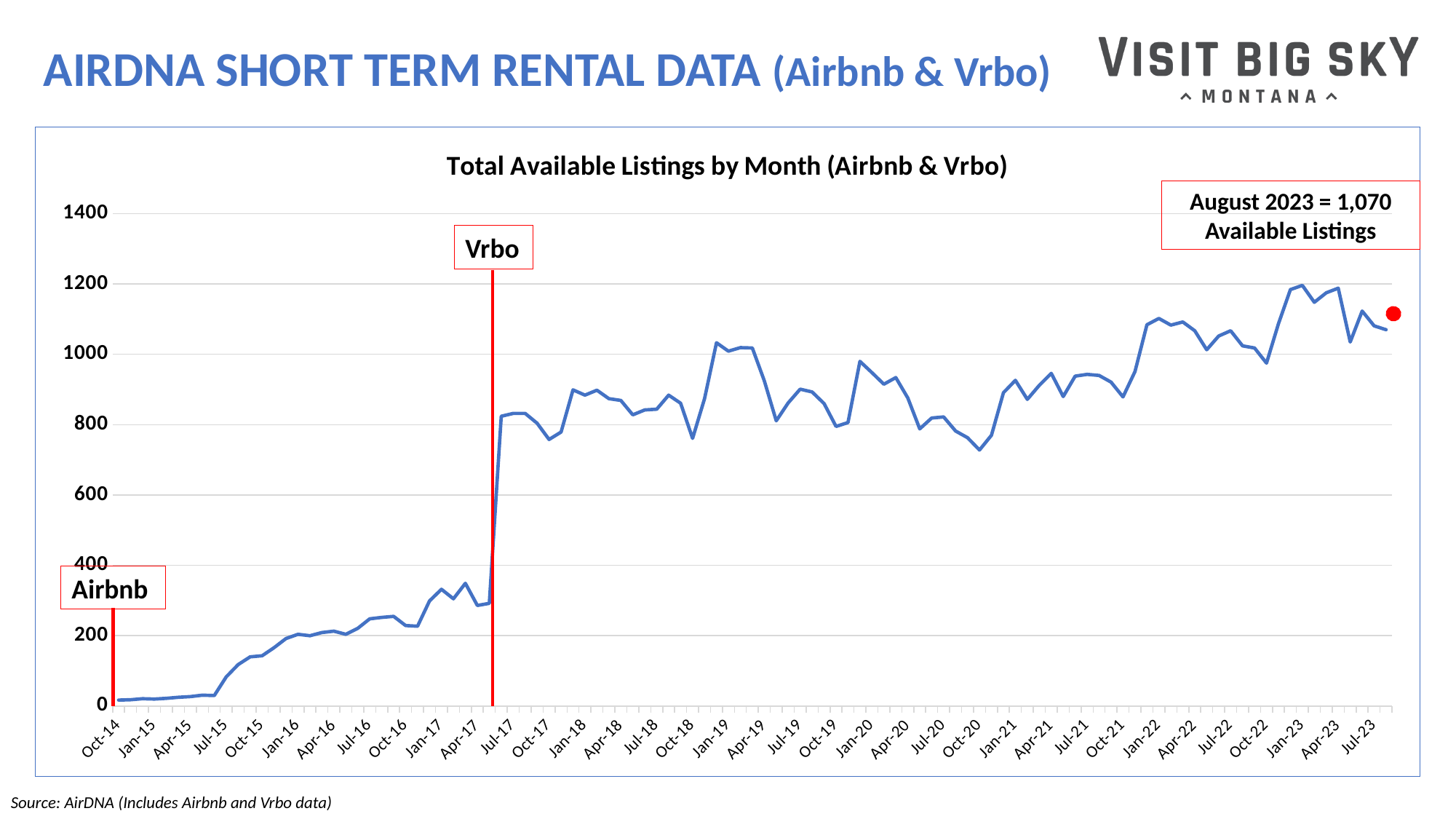
Overall, do the values rise or fall from Oct-14 to Jul-23? rise What is the title of the chart? Total Available Listings by Month (Airbnb & Vrbo) Which is larger, the value for Jan-16 or the value for Jan-18? Jan-18 Is the value for Jul-17 greater or less than 600? greater What kind of chart is shown on the slide? line chart What label is on the first red vertical line near the start of the chart? Airbnb Is the value for Oct-14 greater or less than 200? less Is the value for Jan-23 greater or less than 1000? greater Which is larger, the value for Oct-20 or the value for Jan-22? Jan-22 How many available listings does the chart annotation give for August 2023? 1,070